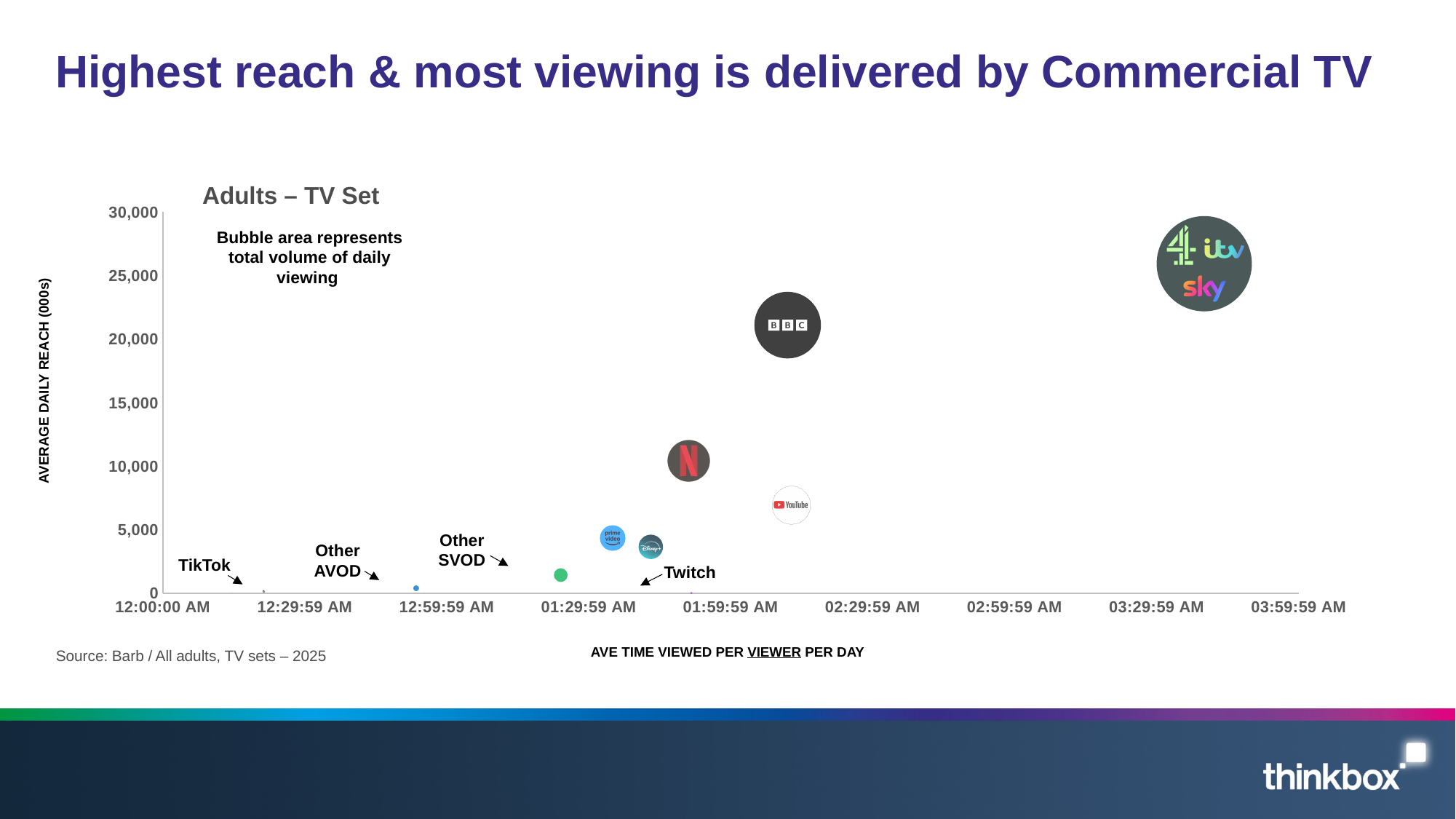
According to the note on the chart, what does the bubble area represent? Total volume of daily viewing Which has the higher average daily reach, YouTube or Prime Video? YouTube Is the average daily reach for the BBC greater or less than 15,000? greater Which has the longer average time viewed per viewer per day, Commercial TV (4 / itv / sky) or the BBC? Commercial TV (4 / itv / sky) Which has the higher average daily reach, the BBC or Netflix? BBC Which bubble has the highest average daily reach? Commercial TV (4 / itv / sky) Is the average daily reach for Other SVOD greater or less than 5,000? less Is the average daily reach for the Commercial TV bubble (4 / itv / sky) greater or less than 20,000? greater What kind of chart is shown on the slide? Bubble chart What is the title of the chart? Adults – TV Set